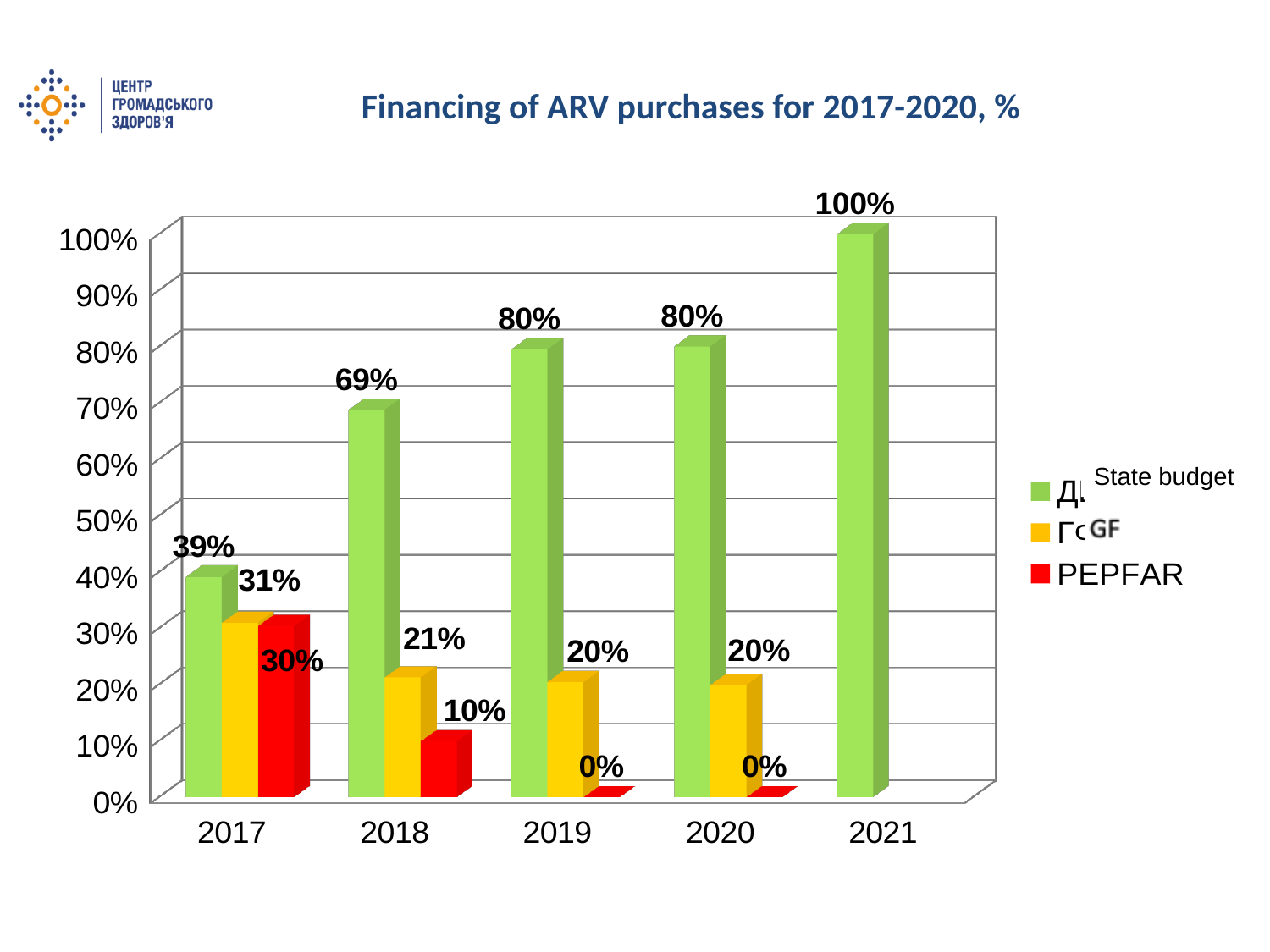
What is the State budget share of ARV purchase financing in 2021? 100% How many years are shown on the x axis? 5 In which year is the State budget share of ARV purchase financing the lowest? 2017 Does the State budget share of ARV purchase financing rise or fall from 2017 to 2021? Rise What is the PEPFAR share of ARV purchase financing in 2018? 10% Which is larger in 2017: the GF share or the PEPFAR share? GF What is the State budget share of ARV purchase financing in 2018? 69% How many series does the legend list? 3 In which year is the PEPFAR share of ARV purchase financing the highest? 2017 By how many percentage points did the State budget share increase from 2017 to 2018? 30 What is the GF share of ARV purchase financing in 2017? 31% What type of chart is shown on the slide? Bar chart